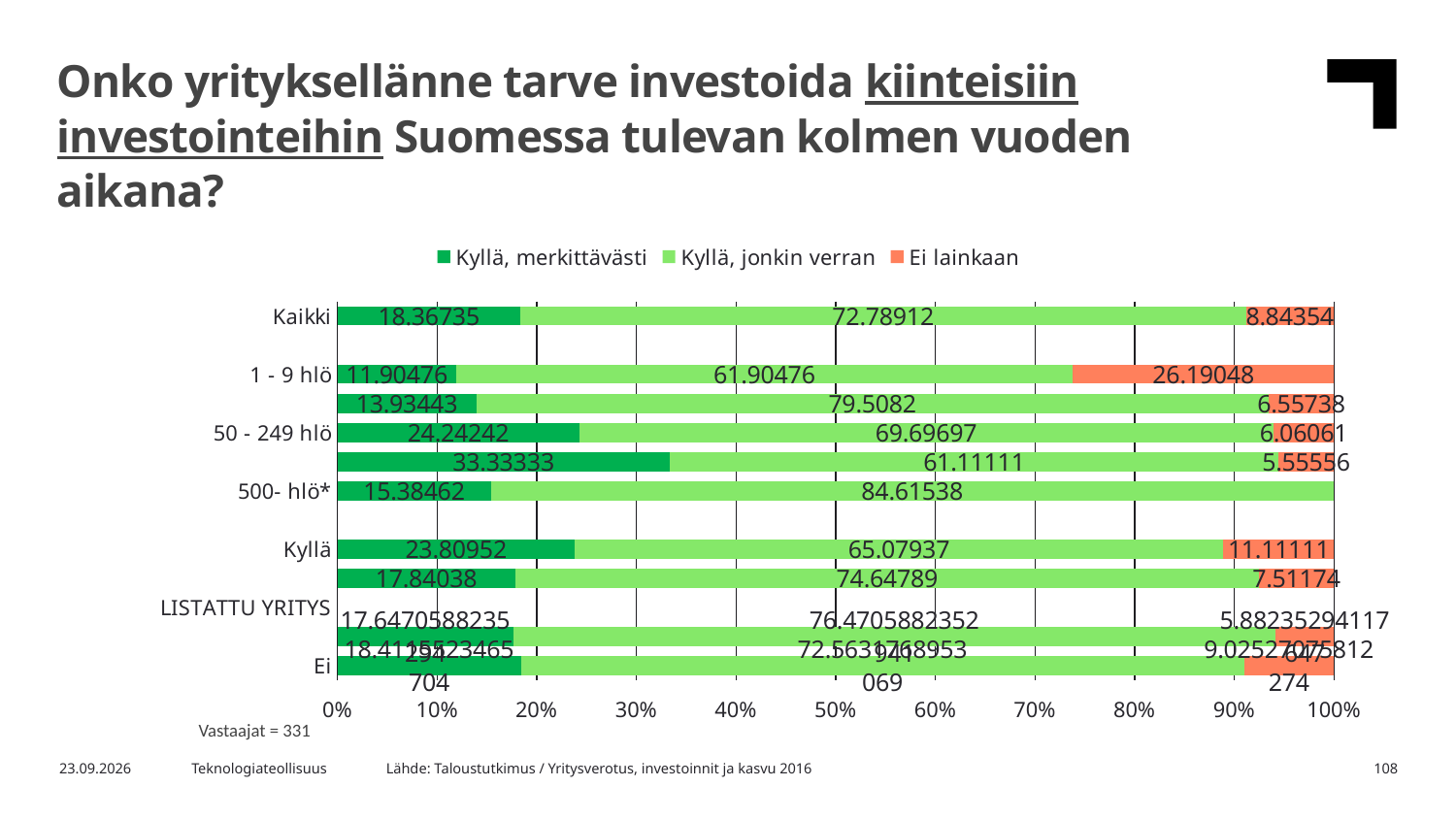
How many series does the legend list? 3 For Kaikki, what is the difference between the "Kyllä, jonkin verran" value and the "Kyllä, merkittävästi" value? 54.42177 What is the first entry in the chart legend? Kyllä, merkittävästi What is the value of "Kyllä, jonkin verran" for 500- hlö*? 84.61538 What is the value of "Kyllä, merkittävästi" for Kaikki? 18.36735 What is the value of "Ei lainkaan" for 1 - 9 hlö? 26.19048 What is the value of "Ei lainkaan" for Kyllä? 11.11111 Which has the larger "Kyllä, merkittävästi" value, 1 - 9 hlö or 50 - 249 hlö? 50 - 249 hlö What is the value of "Kyllä, merkittävästi" for 50 - 249 hlö? 24.24242 Which category has the highest "Kyllä, jonkin verran" value? 500- hlö* What kind of chart is shown on the slide? bar chart Which has the larger "Ei lainkaan" value, Kaikki or 1 - 9 hlö? 1 - 9 hlö